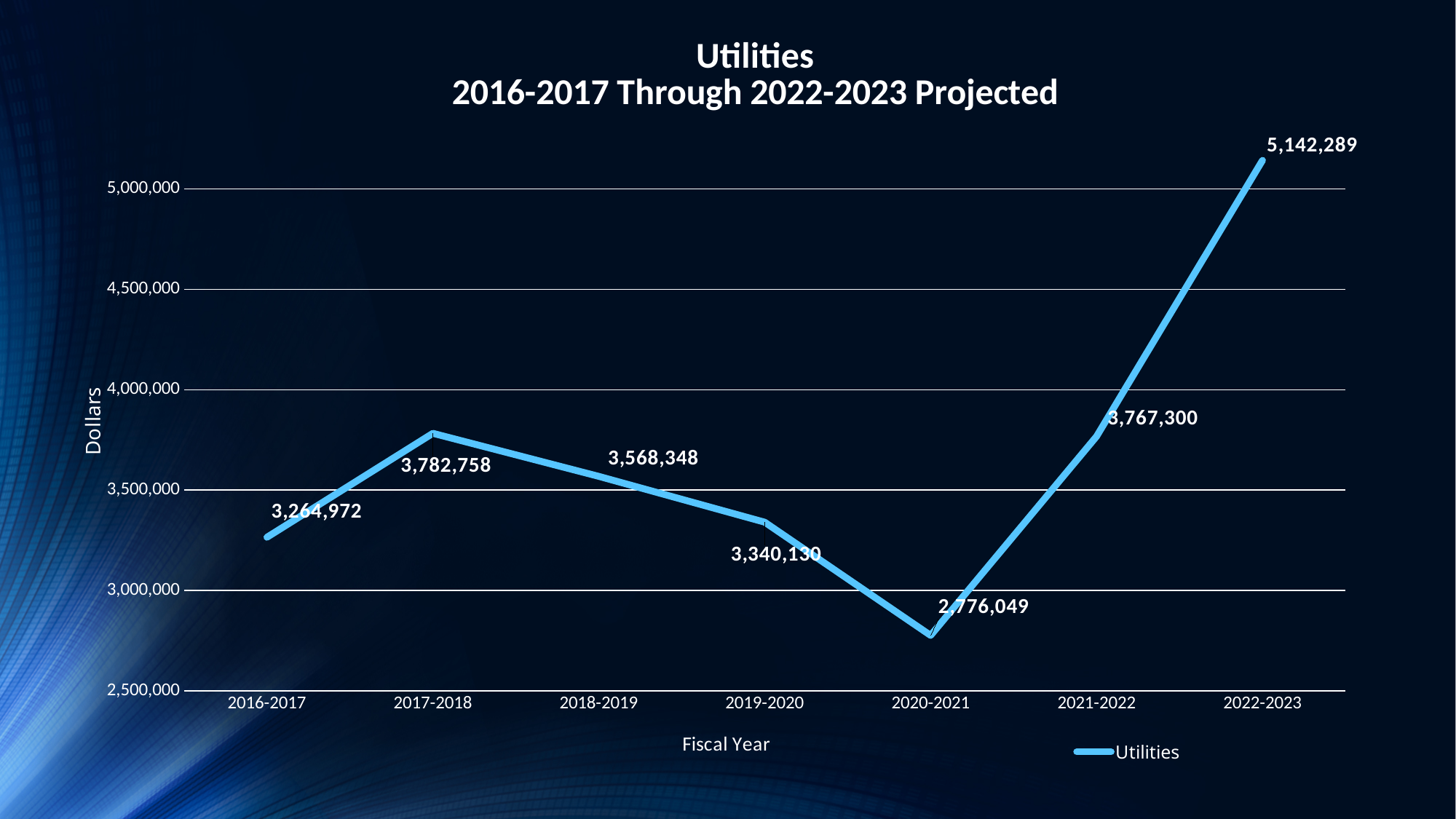
Which fiscal year has the lowest Utilities value? 2020-2021 What is the projected Utilities value for 2022-2023? 5,142,289 What is the difference between the Utilities values for 2022-2023 and 2021-2022? 1,374,989 What is the Utilities value for 2016-2017? 3,264,972 Is the Utilities value for 2020-2021 greater or less than 3,000,000? less How many fiscal years are plotted on the chart? 7 What kind of chart is shown on the slide? line chart What is the Utilities value for 2020-2021? 2,776,049 Which fiscal year has the highest Utilities value? 2022-2023 What is the label of the y axis? Dollars Which is larger, the Utilities value for 2018-2019 or for 2019-2020? 2018-2019 By how much did Utilities increase from 2016-2017 to 2017-2018? 517,786